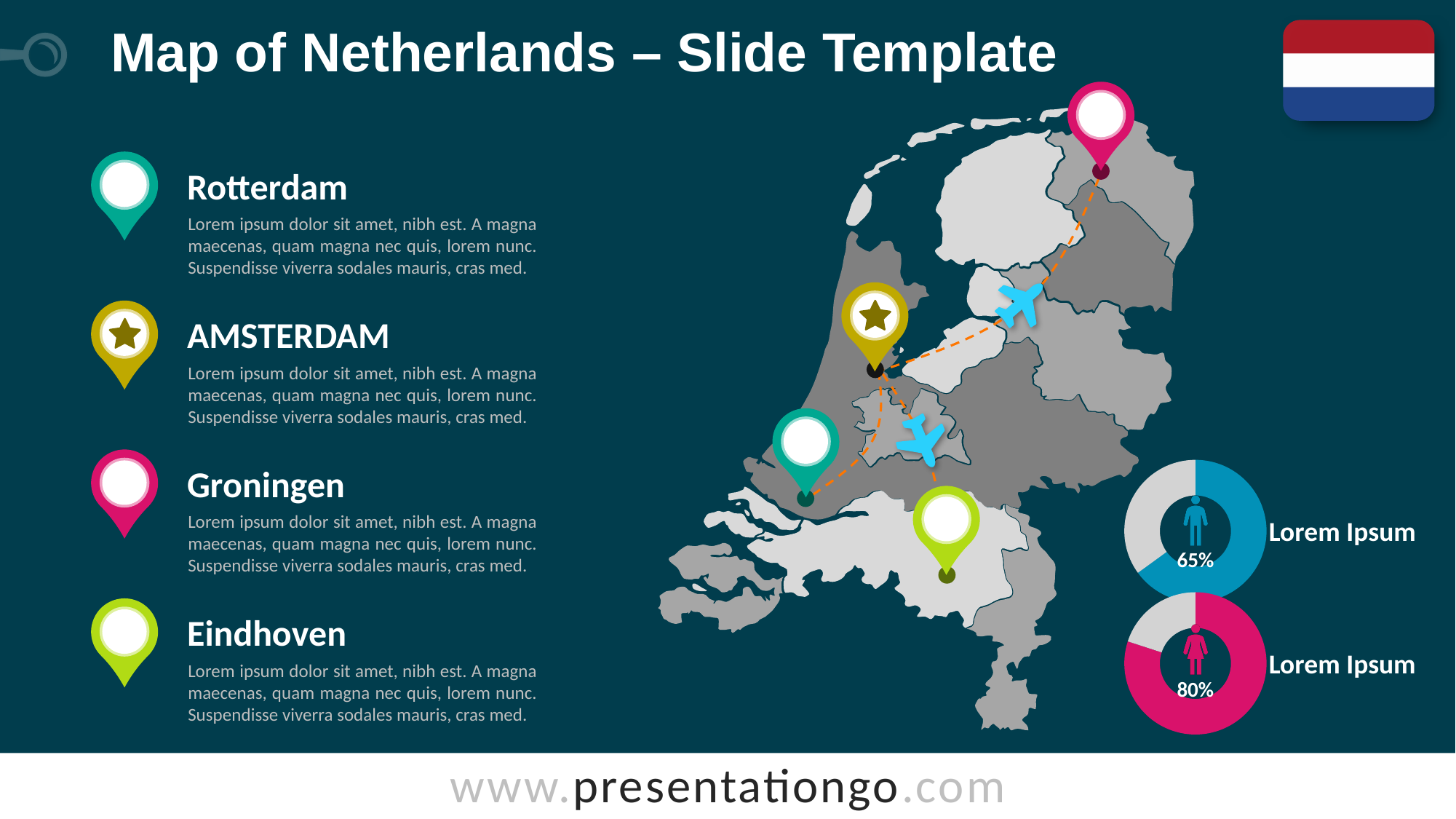
What percentage is shown in the lower (pink) donut chart? 80% What share of the lower pink donut chart is not filled by the 80% segment? 20% What label appears to the right of each donut chart? Lorem Ipsum Is the value shown in the upper blue donut chart greater or less than 50%? greater What colour is the filled segment of the upper donut chart? blue What is the difference between the percentage in the lower pink donut chart and the percentage in the upper blue donut chart? 15 percentage points What kind of chart are the two circular charts on the right side of the slide? donut chart How many donut charts are on the slide? 2 What percentage is shown in the upper (blue) donut chart? 65% What share of the upper blue donut chart is not filled by the 65% segment? 35% Which of the two donut charts shows the larger percentage, the upper blue one or the lower pink one? the lower pink one